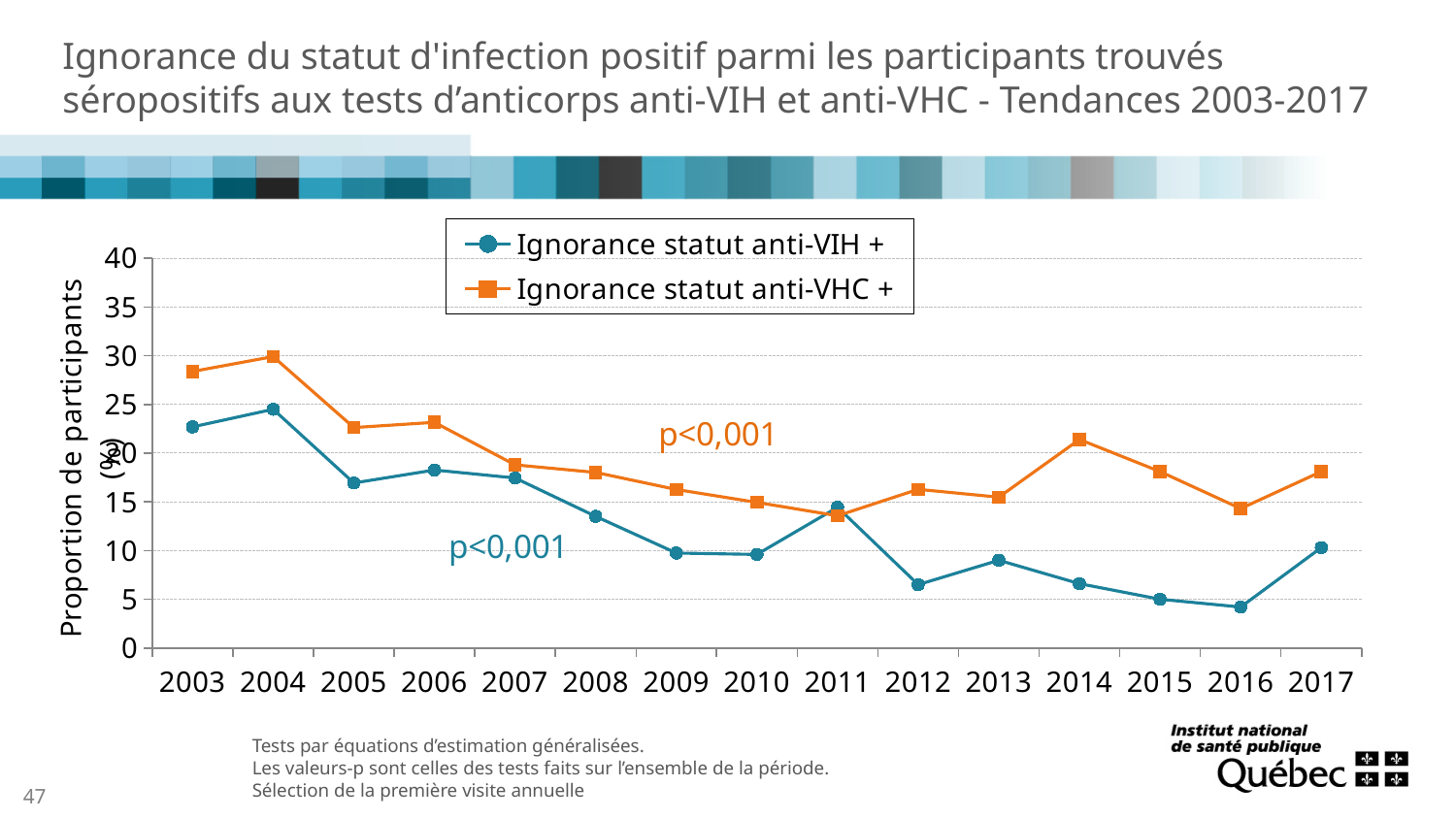
What p-value is annotated next to each line on the chart? p<0,001 How many series does the legend list? 2 Does the Ignorance statut anti-VIH + series overall rise or fall from 2003 to 2017? fall In which year is the value for Ignorance statut anti-VHC + highest? 2004 Is the value for Ignorance statut anti-VHC + in 2004 greater or less than 25? greater How many years are plotted along the x axis? 15 In 2017, which series has the larger value, Ignorance statut anti-VIH + or Ignorance statut anti-VHC +? Ignorance statut anti-VHC + What kind of chart is shown on the slide? line chart Is the value for Ignorance statut anti-VHC + in 2014 greater or less than 20? greater In which year is the value for Ignorance statut anti-VIH + highest? 2004 Is the value for Ignorance statut anti-VIH + in 2012 greater or less than 10? less What is the label of the y axis? Proportion de participants (%)